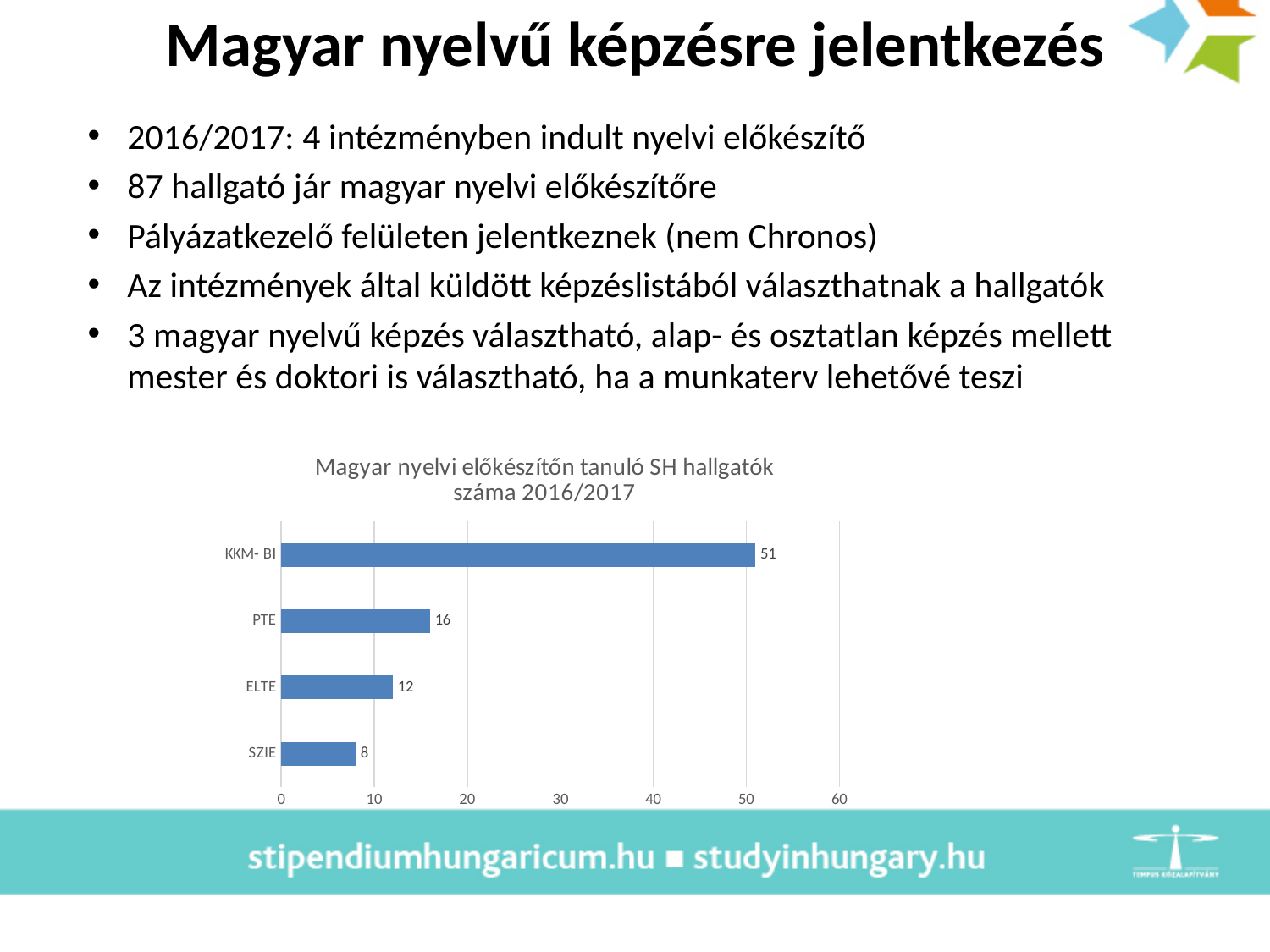
What is the difference between the values for KKM- BI and PTE? 35 Which is larger, the value for ELTE or the value for SZIE? ELTE What is the value for PTE? 16 What is the value for ELTE? 12 What is the value for KKM- BI? 51 Which institution has the highest number of students? KKM- BI What kind of chart is shown on the slide? bar chart How many institutions are shown in the chart? 4 What is the value for SZIE? 8 Is the value for PTE greater or less than 20? less Which institution has the lowest number of students? SZIE What is the title of the chart? Magyar nyelvi előkészítőn tanuló SH hallgatók száma 2016/2017